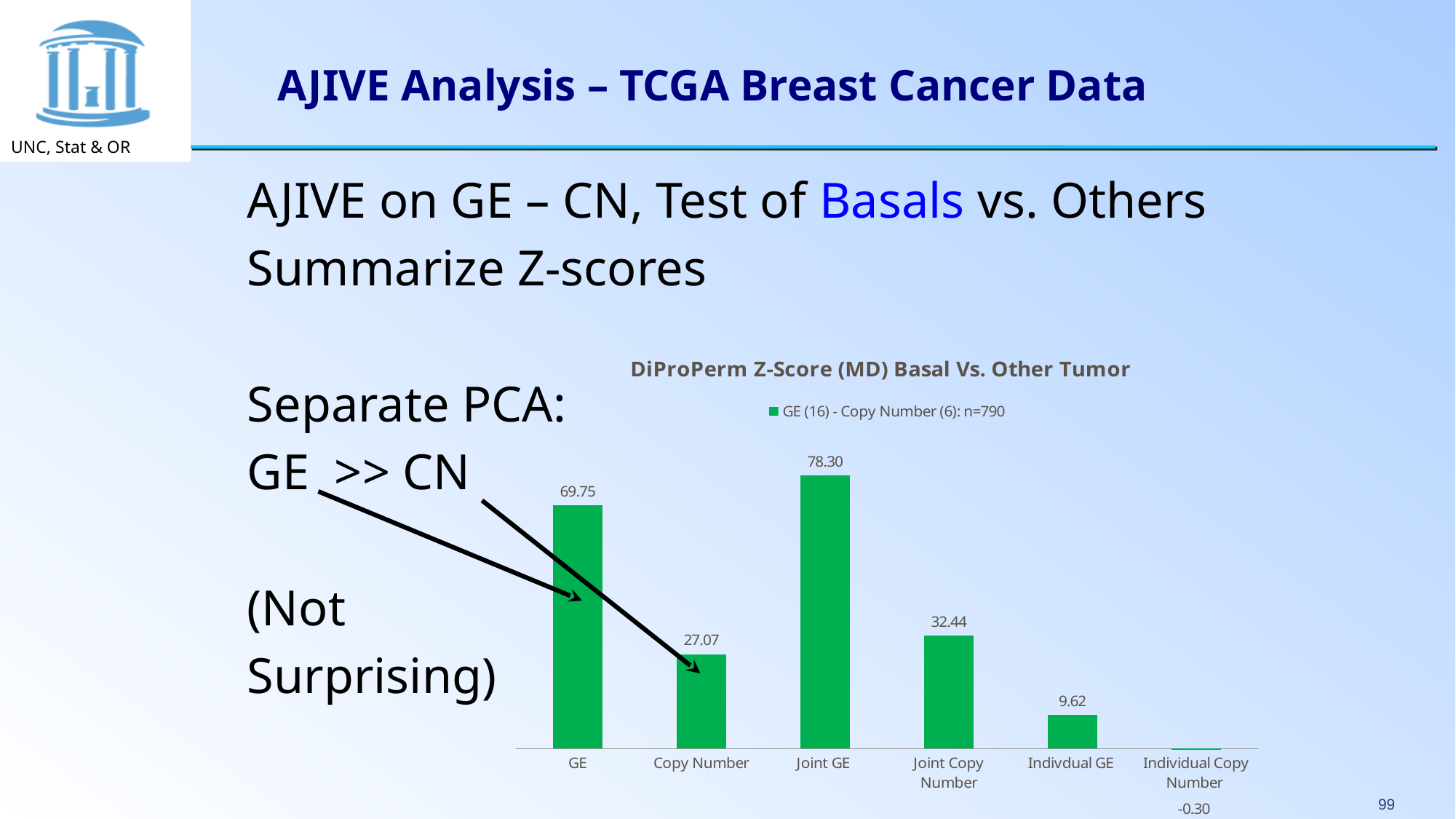
What is the title of the chart? DiProPerm Z-Score (MD) Basal Vs. Other Tumor What is the Z-score value for GE? 69.75 How many series does the legend list? 1 Which is larger, the Z-score for Joint Copy Number or for Indivdual GE? Joint Copy Number How many categories are shown on the x axis of the chart? 6 What is the Z-score value for Individual Copy Number? -0.30 What is the Z-score value for Joint GE? 78.30 Which category has the highest Z-score? Joint GE Which category has the lowest Z-score? Individual Copy Number What kind of chart is shown on the slide? Bar chart What is the legend entry of the chart? GE (16) - Copy Number (6): n=790 What is the difference between the Z-scores for GE and Copy Number? 42.68